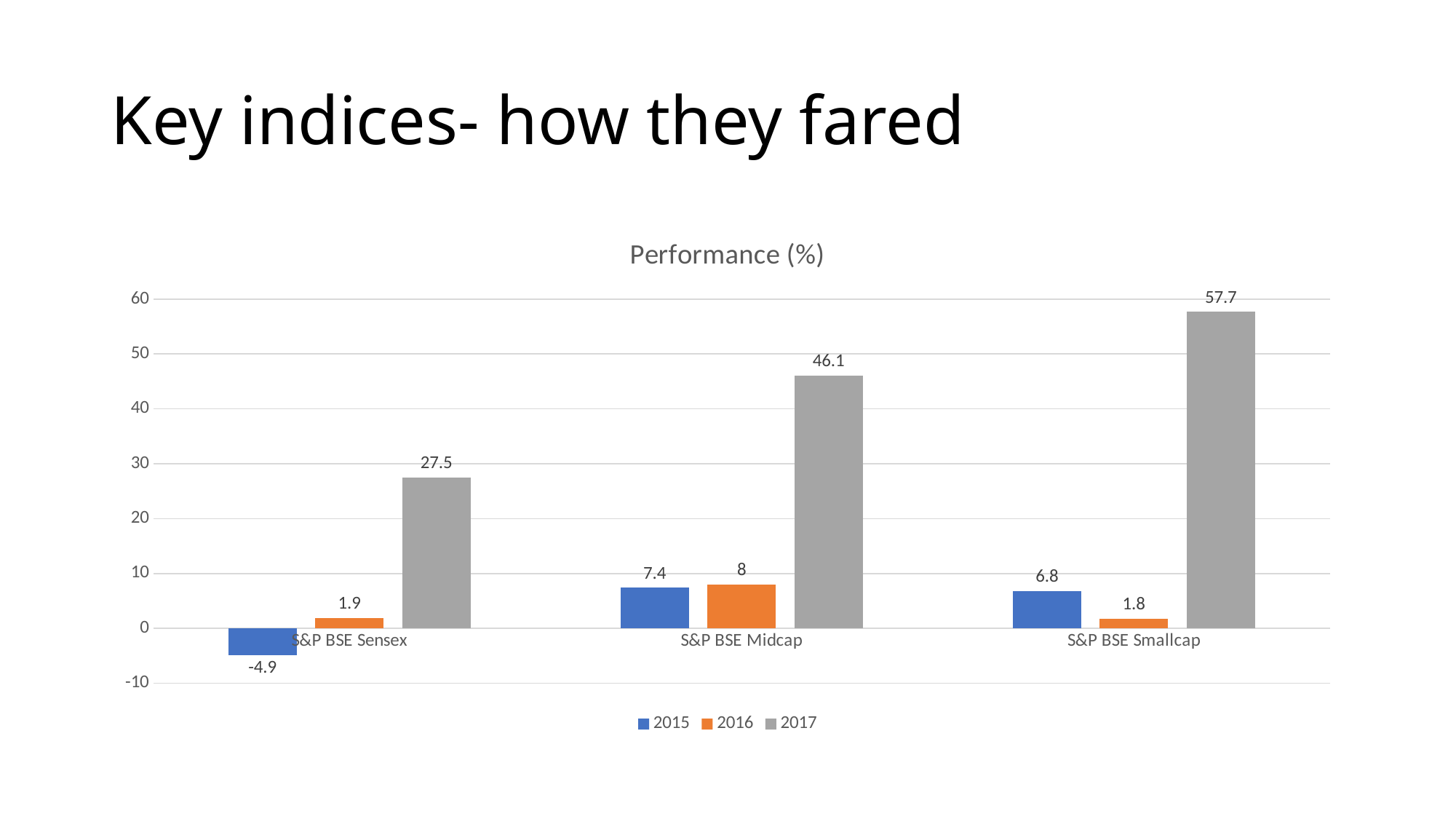
Which index has the highest 2017 value? S&P BSE Smallcap Which index has the lowest 2015 value? S&P BSE Sensex What is the difference between the 2017 values for S&P BSE Smallcap and S&P BSE Midcap? 11.6 Which is larger, the 2015 value for S&P BSE Midcap or the 2015 value for S&P BSE Smallcap? S&P BSE Midcap What is the 2017 value for S&P BSE Smallcap? 57.7 Is the 2017 value for S&P BSE Midcap greater or less than 40? greater What is the title of the chart? Performance (%) What is the 2015 value for S&P BSE Sensex? -4.9 What is the 2016 value for S&P BSE Midcap? 8 How many indices are shown on the x axis? 3 How many series does the legend list? 3 What kind of chart is shown? bar chart